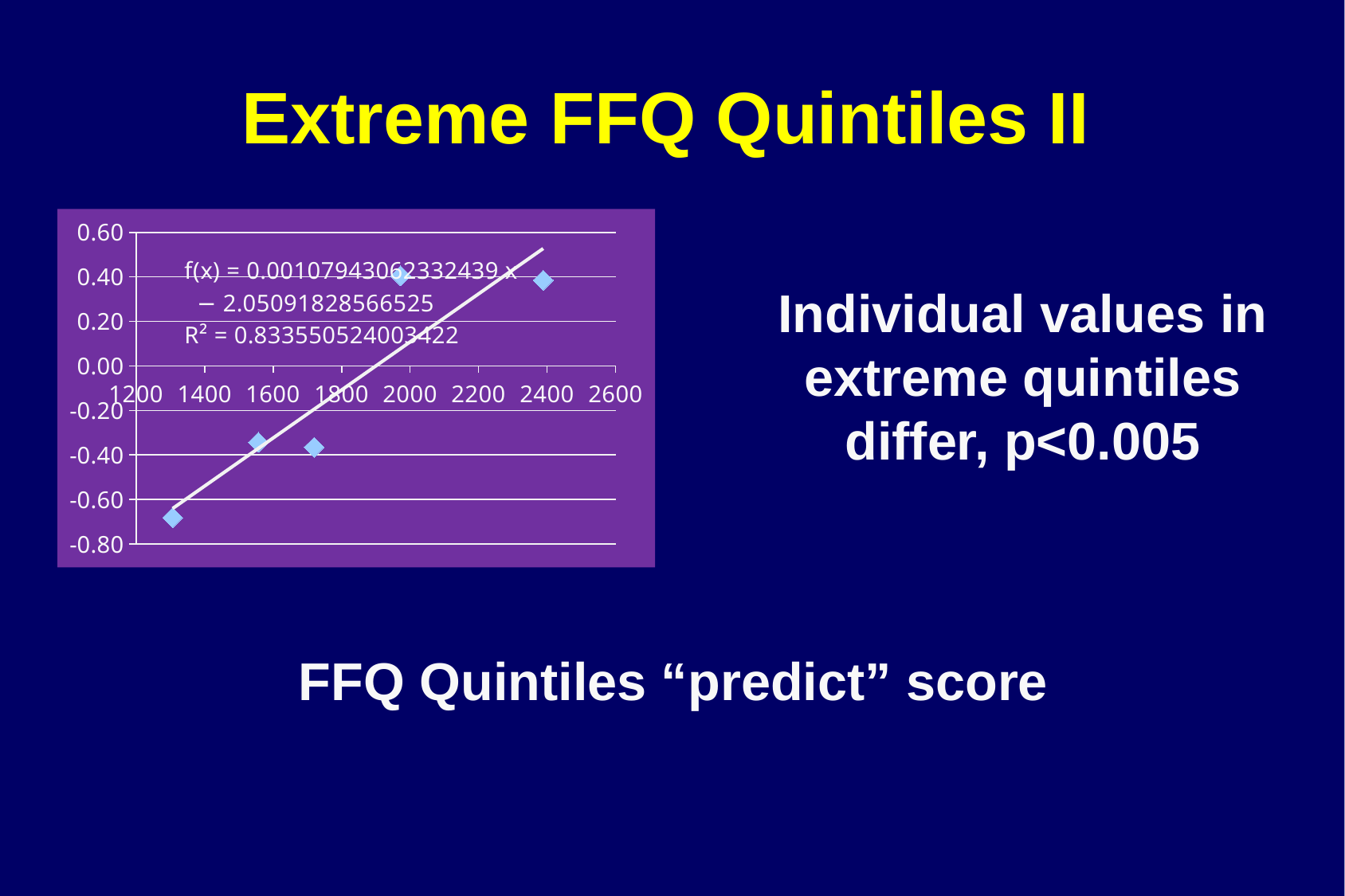
Do the plotted values generally rise or fall as the x value increases from 1200 to 2600? rise What is the R² value printed on the chart? 0.833550524003422 Is the y value of the rightmost plotted point (near x = 2400) greater or less than 0.20? greater How many plotted points have a y value below 0.00? 3 Which has the larger y value: the leftmost plotted point or the rightmost plotted point? the rightmost point What kind of chart is shown on the slide? scatter chart How many plotted points have a y value above 0.00? 2 What is the highest tick label shown on the y axis? 0.60 Is the y value of the plotted point near x = 1600 greater or less than -0.20? less How many data points are plotted on the chart? 5 Is the y value of the leftmost plotted point (near x = 1300) greater or less than -0.60? less